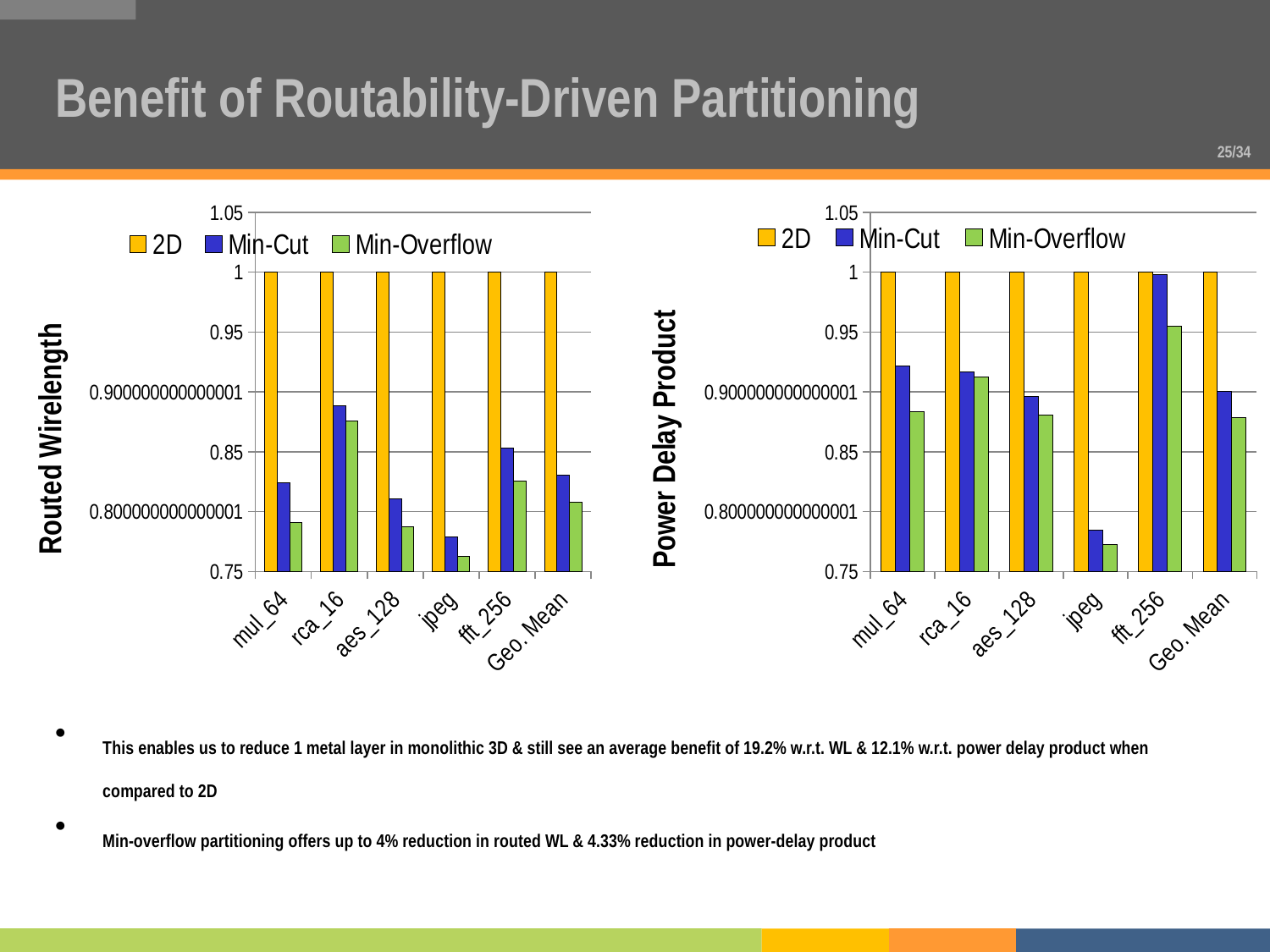
How many categories are shown on the x axis of the Routed Wirelength chart? 6 In the Power Delay Product chart, is the Min-Cut value for mul_64 greater or less than 0.9? greater In the Routed Wirelength chart, is the Min-Cut value for mul_64 greater or less than 0.8? greater How many series does the legend of the Power Delay Product chart list? 3 In the Power Delay Product chart, which category has the lowest Min-Overflow value? jpeg In the Routed Wirelength chart, what is the value of the 2D series for mul_64? 1 In the Routed Wirelength chart, which category has the highest Min-Cut value? rca_16 In the Power Delay Product chart, what is the value of the 2D series for jpeg? 1 In the Routed Wirelength chart, for rca_16, which is larger: the Min-Cut value or the Min-Overflow value? Min-Cut What kind of chart is the Routed Wirelength chart on the left? bar chart In the Power Delay Product chart, is the Min-Cut value for jpeg greater or less than 0.8? less